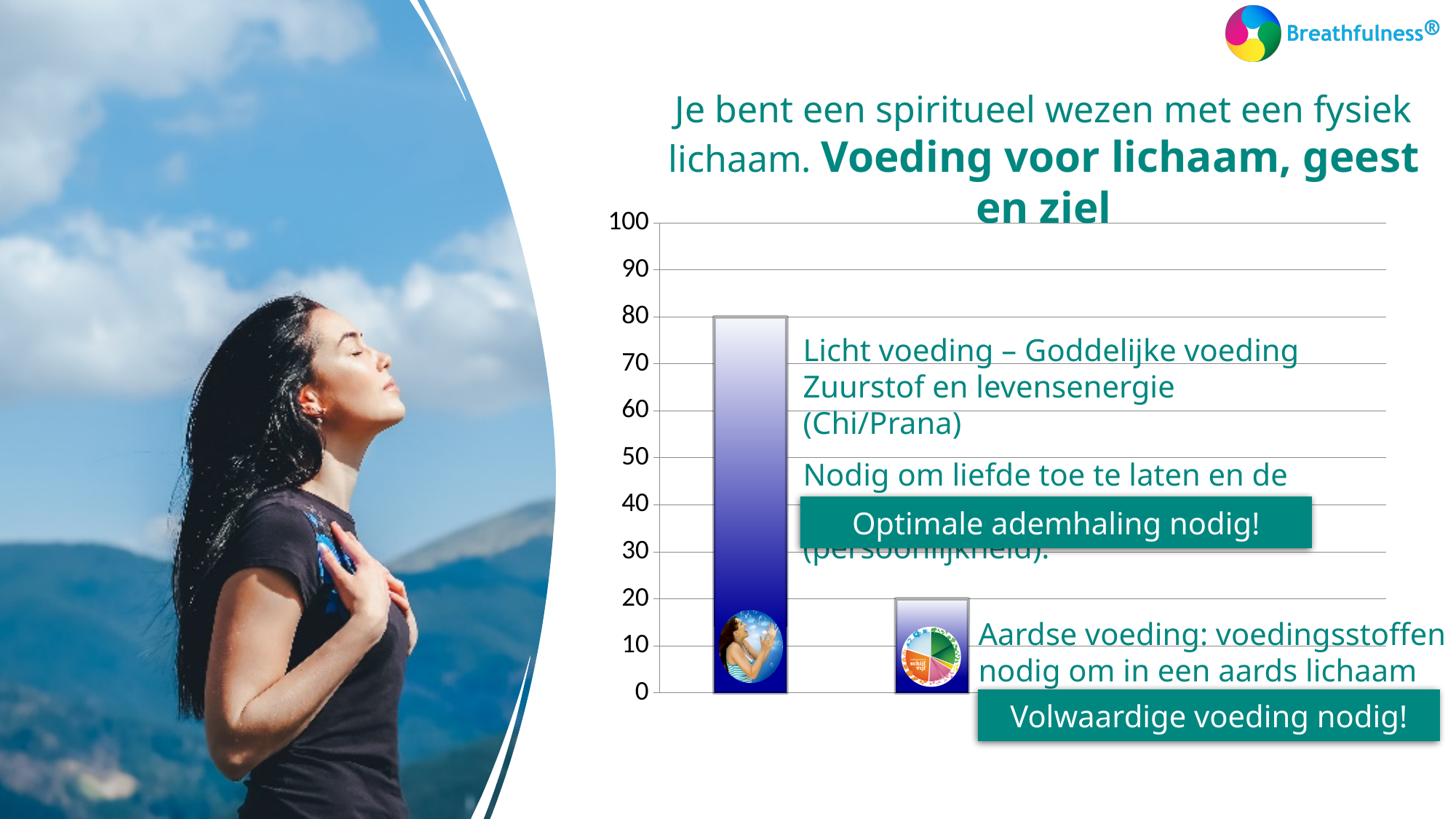
Is the value of the left bar greater or less than 50? greater How many bars are plotted in the chart? 2 What is the highest value shown on the y axis? 100 Which bar is the tallest in the chart? the left bar (Licht voeding – Goddelijke voeding) What kind of chart is shown on the slide? bar chart What value does the left bar (Licht voeding – Goddelijke voeding) reach on the y axis? 80 What is the interval between consecutive tick marks on the y axis? 10 Is the value of the right bar greater or less than 50? less Which is larger, the left bar (Licht voeding) or the right bar (Aardse voeding)? the left bar (Licht voeding) What is the difference between the left bar and the right bar? 60 What value does the right bar (Aardse voeding) reach on the y axis? 20 Which bar is the shortest in the chart? the right bar (Aardse voeding)